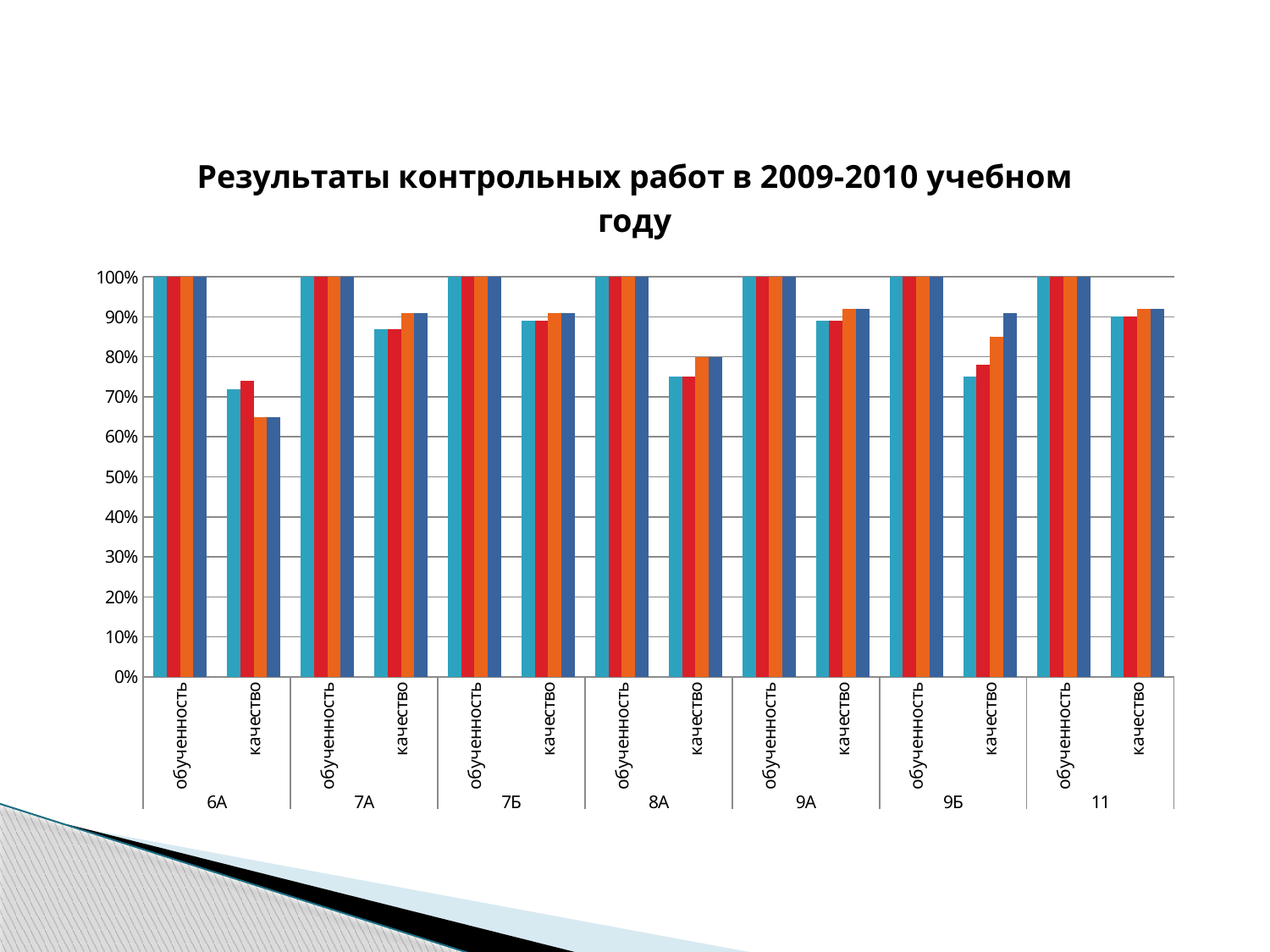
Is the value of the first (light blue) качество bar for class 8А greater or less than 80%? less How many bars are plotted for each обученность or качество group? 4 Which is larger: the first качество bar for class 6А or the first качество bar for class 7А? 7А Is the value of the dark blue качество bar for class 7А greater or less than 80%? greater Is the value of the first (light blue) качество bar for class 9Б greater or less than 80%? less How many classes are shown along the x axis of the chart? 7 What is the title of the chart? Результаты контрольных работ в 2009-2010 учебном году What kind of chart is shown on the slide? bar chart What value do the обученность bars for class 6А reach? 100% Which class has the lowest качество values? 6А